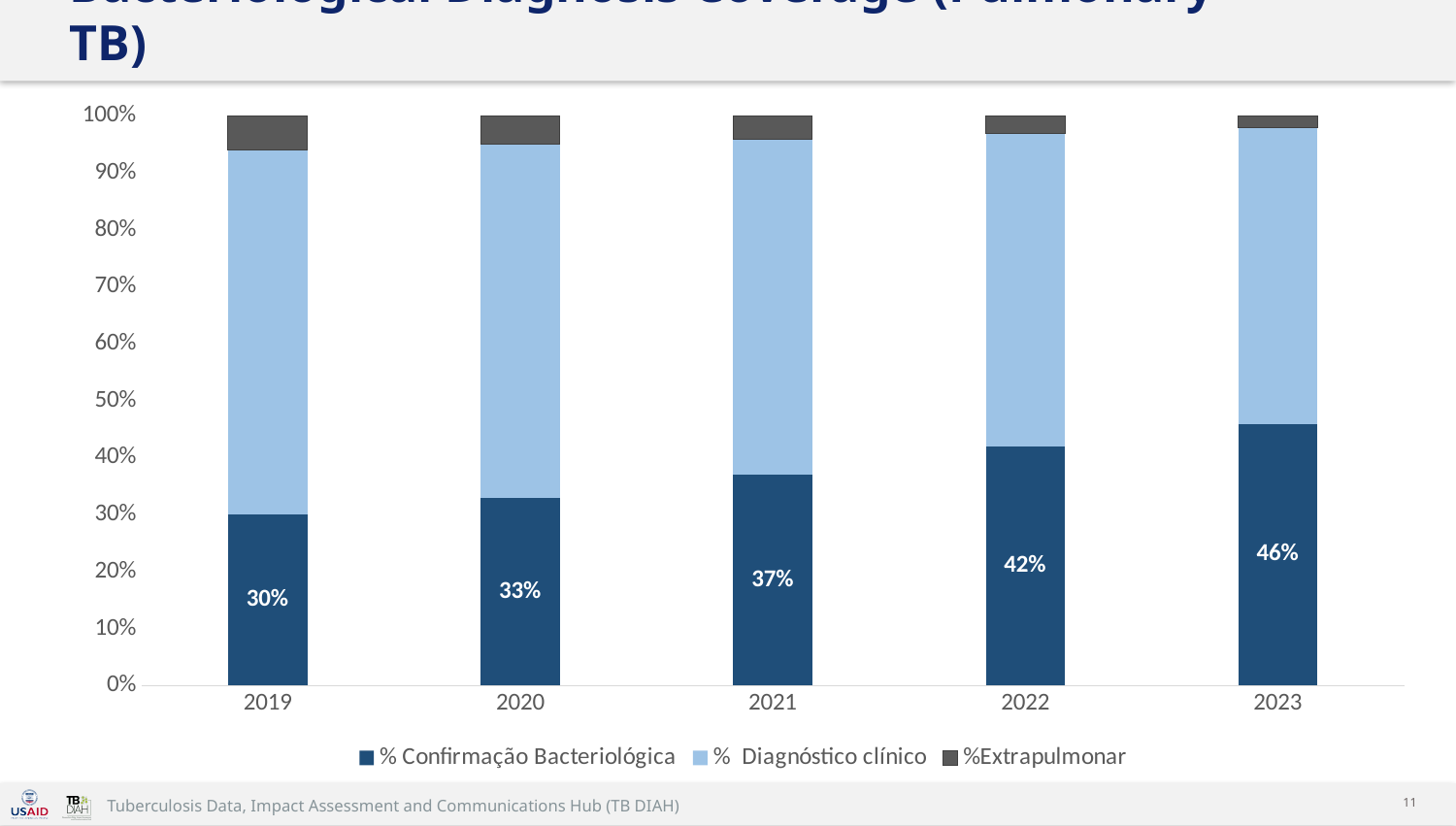
Does the % Confirmação Bacteriológica value rise or fall from 2019 to 2023? Rise What is the difference between the % Confirmação Bacteriológica values for 2023 and 2019? 16% Which year has the lowest % Confirmação Bacteriológica value? 2019 What is the % Confirmação Bacteriológica value for 2019? 30% How many years are shown on the x axis? 5 Which year has the highest % Confirmação Bacteriológica value? 2023 What is the % Confirmação Bacteriológica value for 2021? 37% Is the % Diagnóstico clínico segment for 2019 greater or less than 50%? greater What is the % Confirmação Bacteriológica value for 2023? 46% How many series does the legend list? 3 Which is larger, the % Confirmação Bacteriológica value for 2020 or for 2022? 2022 What kind of chart is shown on the slide? Stacked bar chart